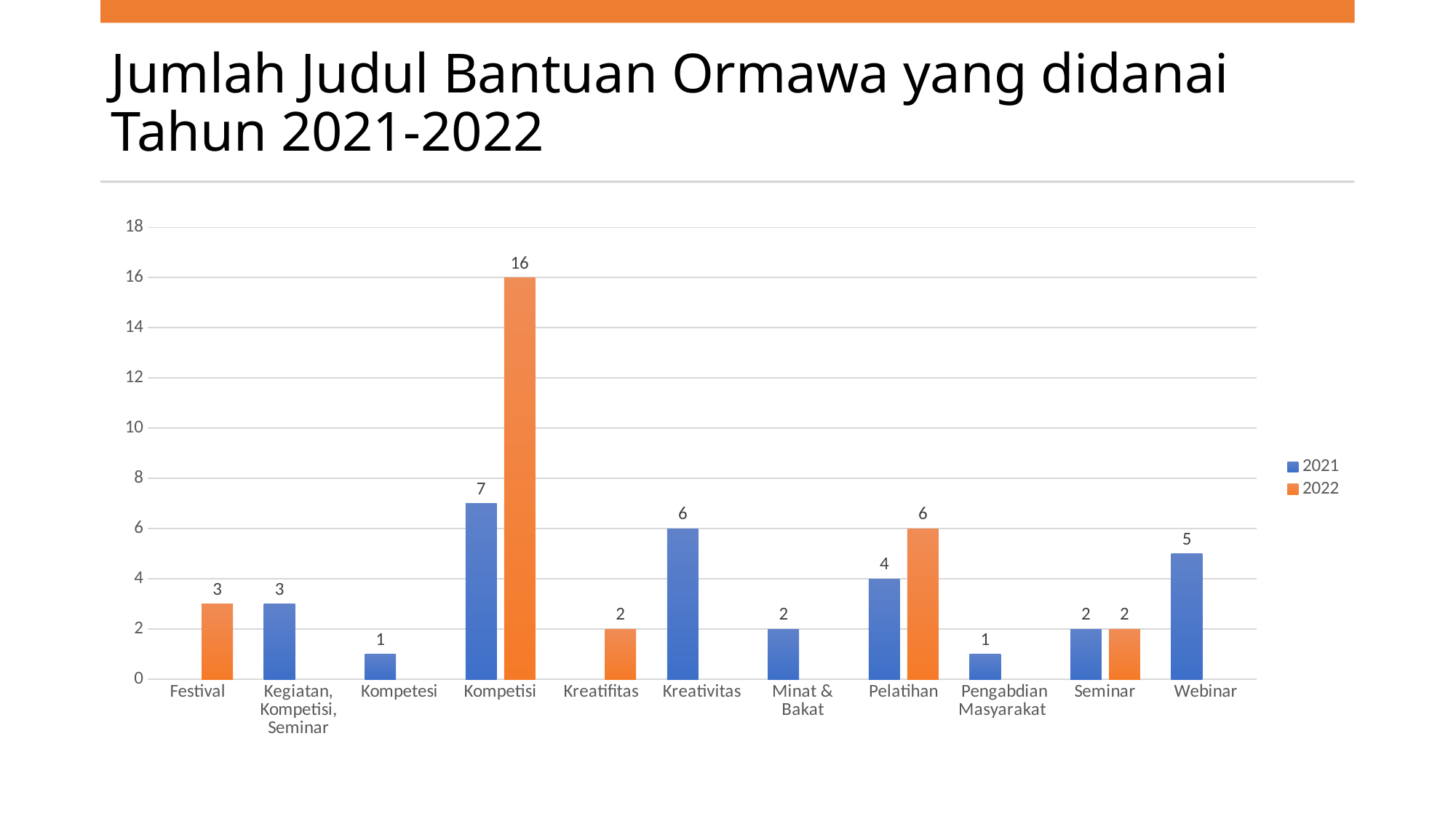
What is the difference between the 2022 and 2021 values for Kompetisi? 9 What is the difference between the 2022 and 2021 values for Pelatihan? 2 Which category has the highest 2022 value? Kompetisi What is the 2021 value for Webinar? 5 Which is larger for Pelatihan, the 2021 value or the 2022 value? 2022 How many categories are shown on the x axis? 11 What is the 2022 value for Festival? 3 What kind of chart is shown on the slide? Bar chart Which category has the highest 2021 value? Kompetisi What is the 2021 value for Kreativitas? 6 What is the 2022 value for Kompetisi? 16 How many series does the legend list? 2